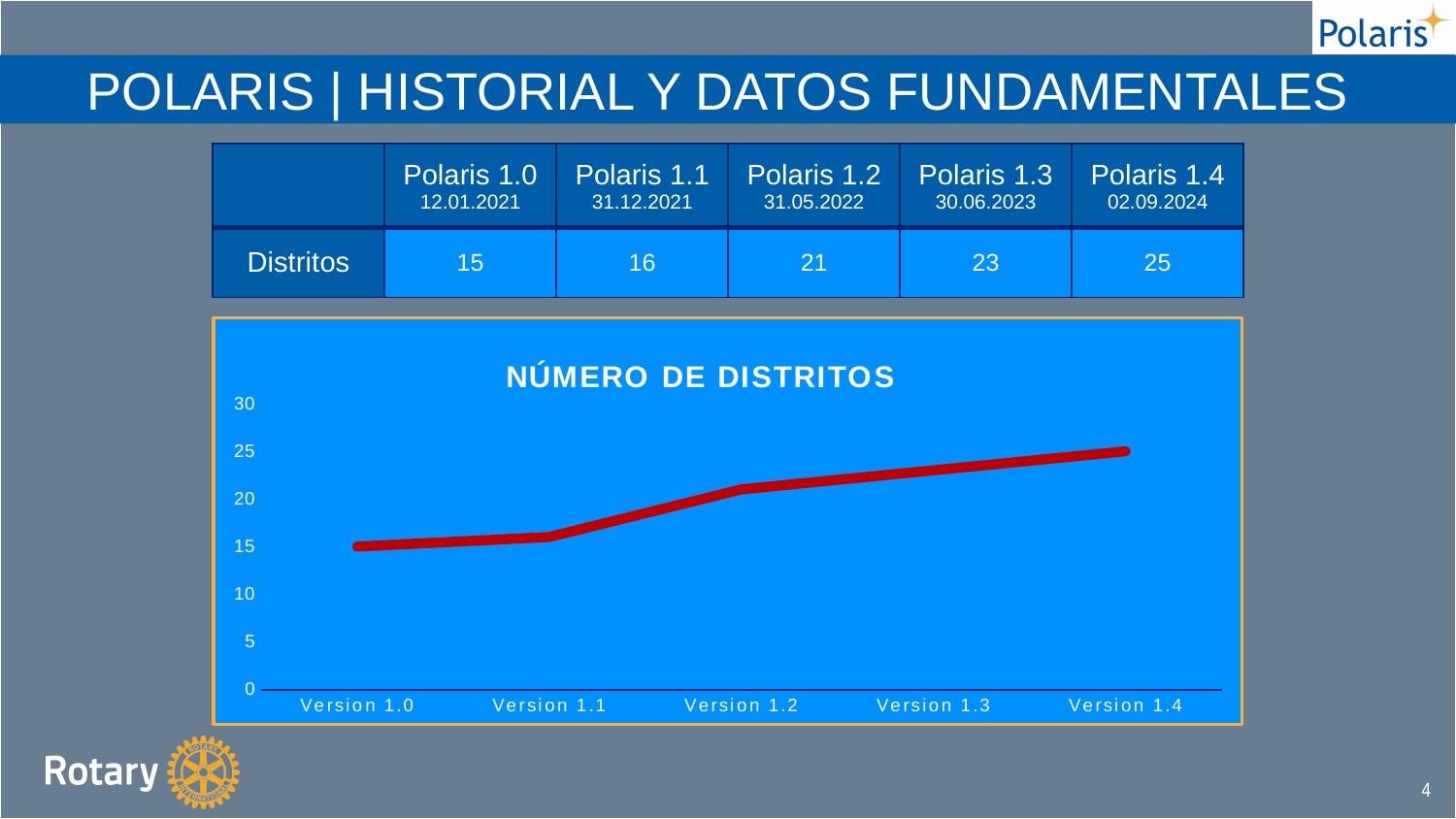
Do the values rise or fall from Version 1.0 to Version 1.4? rise What is the number of districts for Version 1.4? 25 Which is larger, the value for Version 1.1 or the value for Version 1.2? Version 1.2 What kind of chart is shown on the slide? line chart Is the value for Version 1.3 greater or less than 20? greater What is the title of the chart? NÚMERO DE DISTRITOS How many versions are plotted along the x axis of the chart? 5 What is the number of districts for Version 1.0? 15 What is the number of districts for Version 1.2? 21 Which version has the lowest number of districts? Version 1.0 What is the difference between the number of districts for Version 1.4 and Version 1.0? 10 Which version has the highest number of districts? Version 1.4